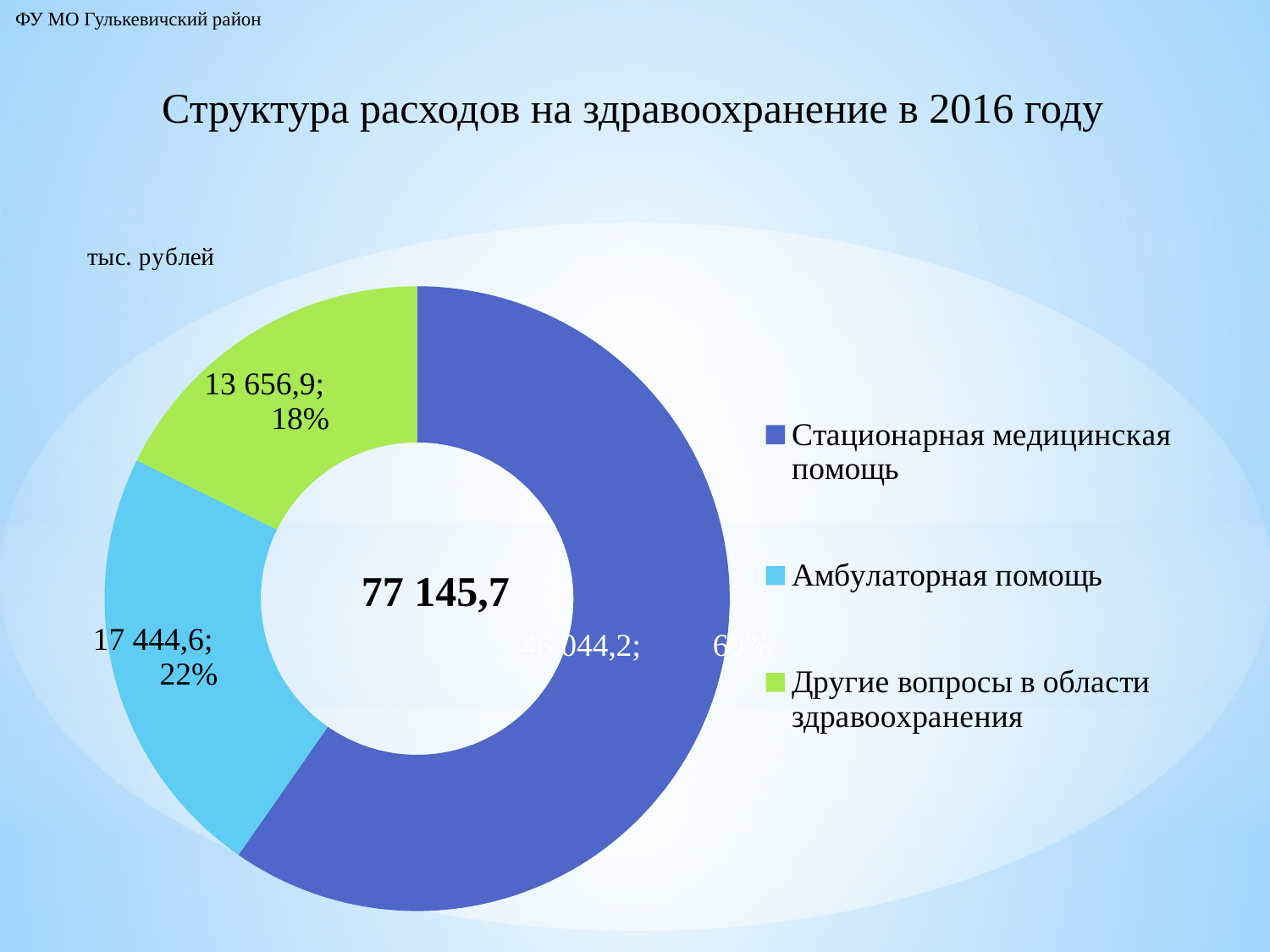
What is the difference between the values for Амбулаторная помощь and Другие вопросы в области здравоохранения? 3 787,7 What is the title of the chart? Структура расходов на здравоохранение в 2016 году What kind of chart is shown on the slide? doughnut (pie) chart How many categories does the chart show? 3 What total value is shown in the centre of the chart? 77 145,7 What is the value for Амбулаторная помощь? 17 444,6 Which category has the largest value? Стационарная медицинская помощь What is the value for Другие вопросы в области здравоохранения? 13 656,9 What share of the chart does Стационарная медицинская помощь take? 60% What share of the chart does Амбулаторная помощь take? 22% What is the value for Стационарная медицинская помощь? 46 044,2 Which category has the smallest value? Другие вопросы в области здравоохранения